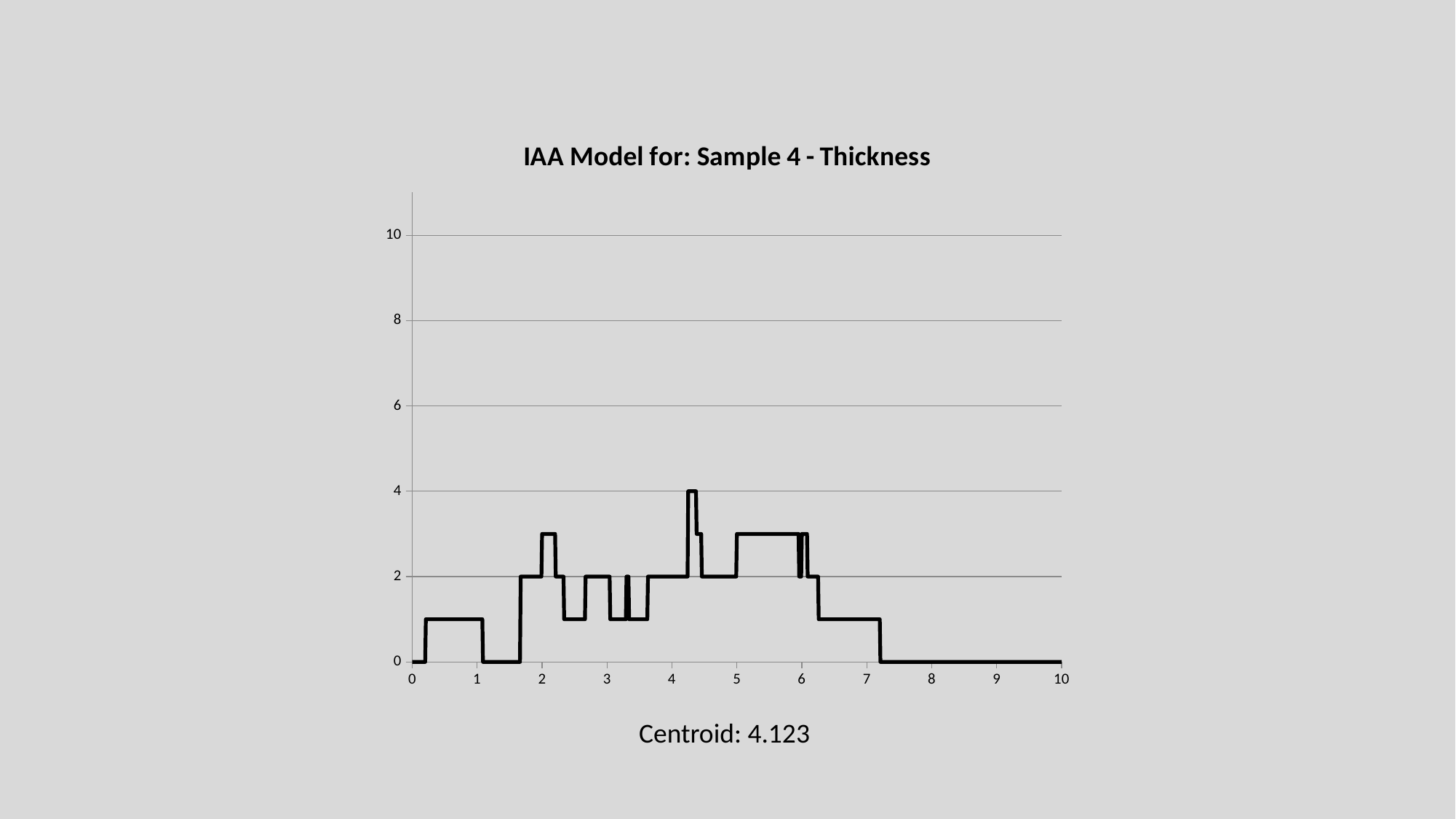
What kind of chart is shown on the slide? line chart What centroid value is printed below the chart? 4.123 What is the value of the line at x = 7? 1 What is the value of the line at x = 1? 1 What is the lowest value the line reaches? 0 Do the values rise or fall along the x axis from x = 6 to x = 8? fall What is the title of the chart? IAA Model for: Sample 4 - Thickness Is the value of the line at x = 9 greater or less than 2? less What is the highest value the line reaches? 4 Which is larger, the value at x = 5 or the value at x = 7? x = 5 What is the value of the line at x = 8? 0